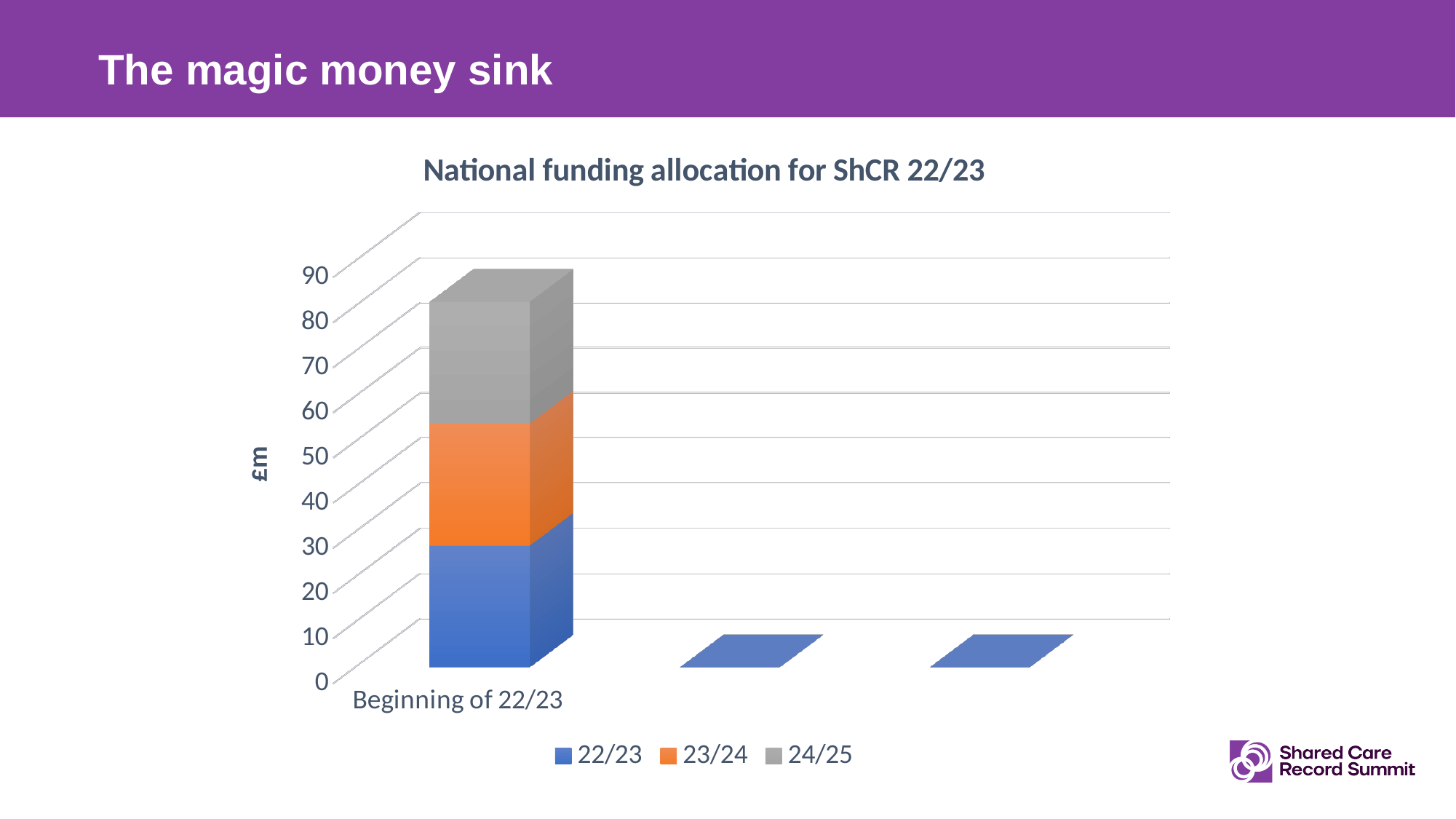
What is the title of the chart? National funding allocation for ShCR 22/23 Is the 22/23 segment of the Beginning of 22/23 bar greater or less than 40? less Is the total height of the stacked bar for Beginning of 22/23 greater or less than 90? less Is the total height of the stacked bar for Beginning of 22/23 greater or less than 70? greater What is the label on the vertical axis? £m How many labelled categories are shown on the horizontal axis? 1 What kind of chart is shown on the slide? Stacked bar chart How many series does the legend list? 3